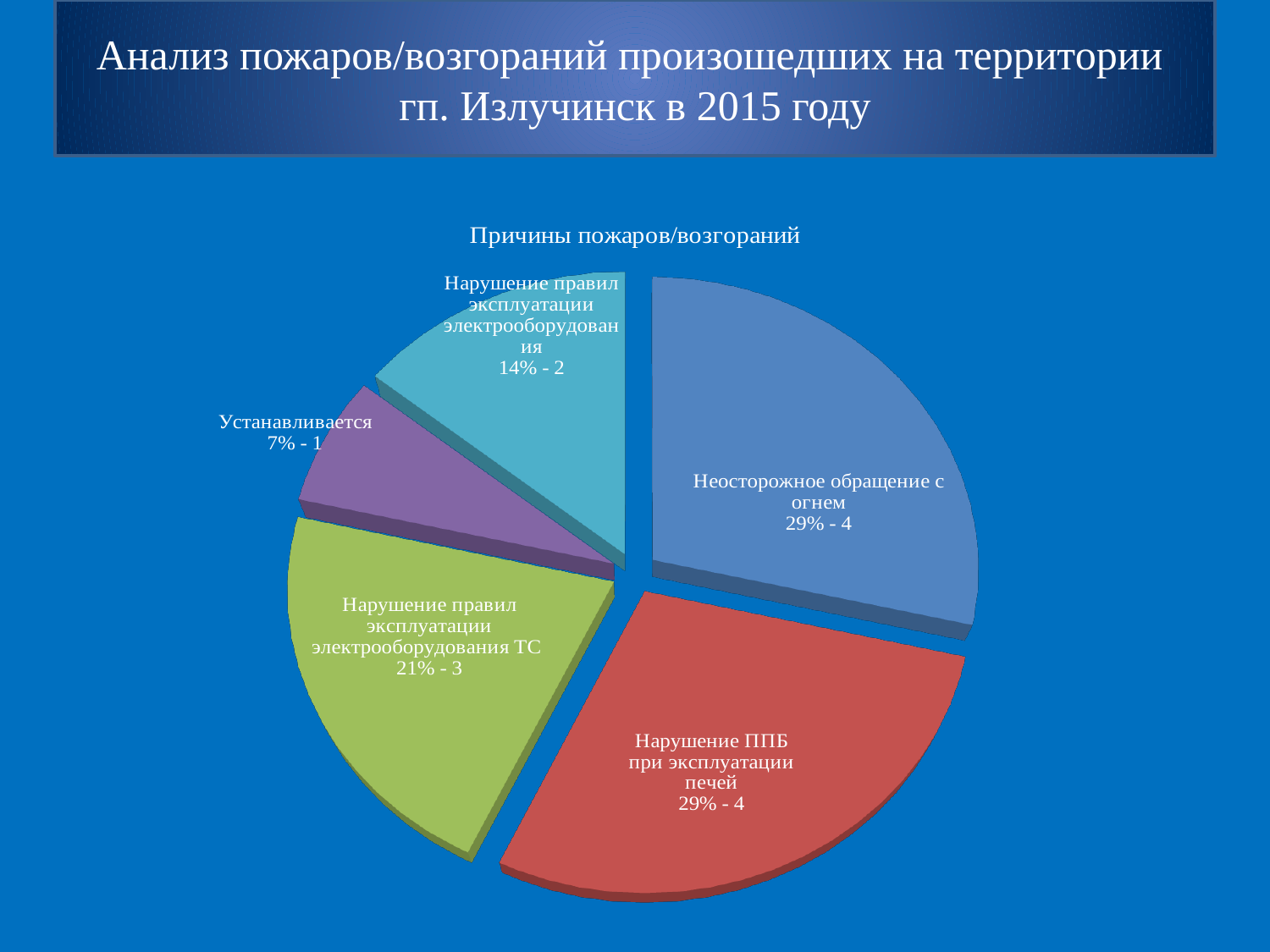
What is the title of the chart? Причины пожаров/возгораний How many fires are attributed to "Нарушение ППБ при эксплуатации печей"? 4 Which category has the smallest slice of the pie? Устанавливается What share of the pie does "Нарушение правил эксплуатации электрооборудования ТС" have? 21% How many slices does the pie chart have? 5 Which is larger: the slice for "Нарушение правил эксплуатации электрооборудования ТС" or the slice for "Нарушение правил эксплуатации электрооборудования"? Нарушение правил эксплуатации электрооборудования ТС What kind of chart is shown on the slide? Pie chart What share of the pie does "Неосторожное обращение с огнем" have? 29% How many fires are attributed to "Нарушение правил эксплуатации электрооборудования"? 2 What colour is the slice for "Нарушение ППБ при эксплуатации печей"? Red What share of the pie does "Устанавливается" have? 7% What is the difference in percentage points between "Неосторожное обращение с огнем" and "Устанавливается"? 22